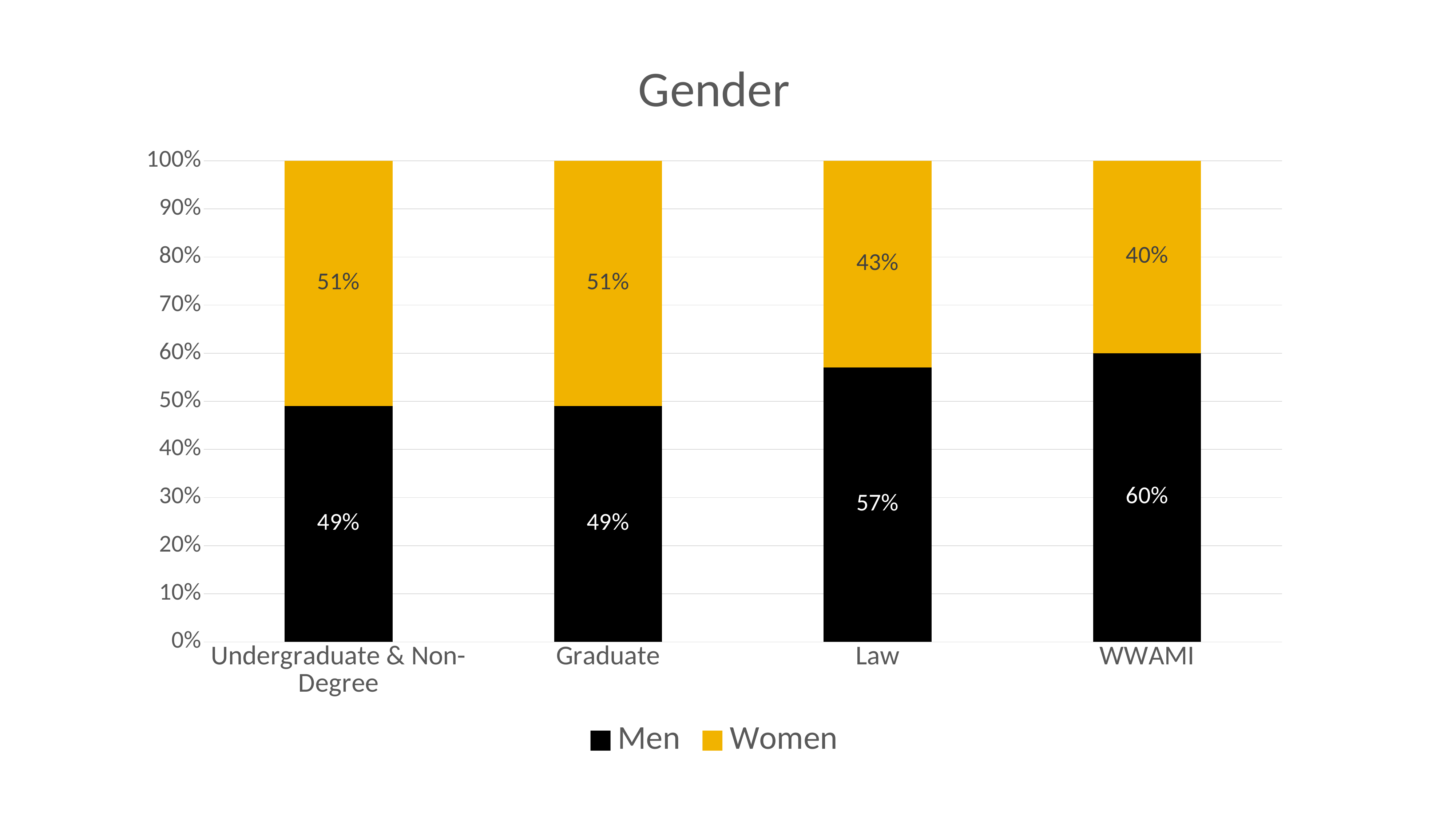
What kind of chart is shown? Stacked bar chart How many categories are shown on the x axis? 4 What is the Men value for Graduate? 49% What is the Women value for Undergraduate & Non-Degree? 51% Is the Women percentage larger for Law or for WWAMI? Law What percentage of WWAMI students are women? 40% How many series does the legend list? 2 What percentage of Law students are men? 57% What is the title of the chart? Gender Which category has the highest percentage of men? WWAMI Which category has the lowest percentage of women? WWAMI What is the difference between the Men and Women percentages for Law? 14%